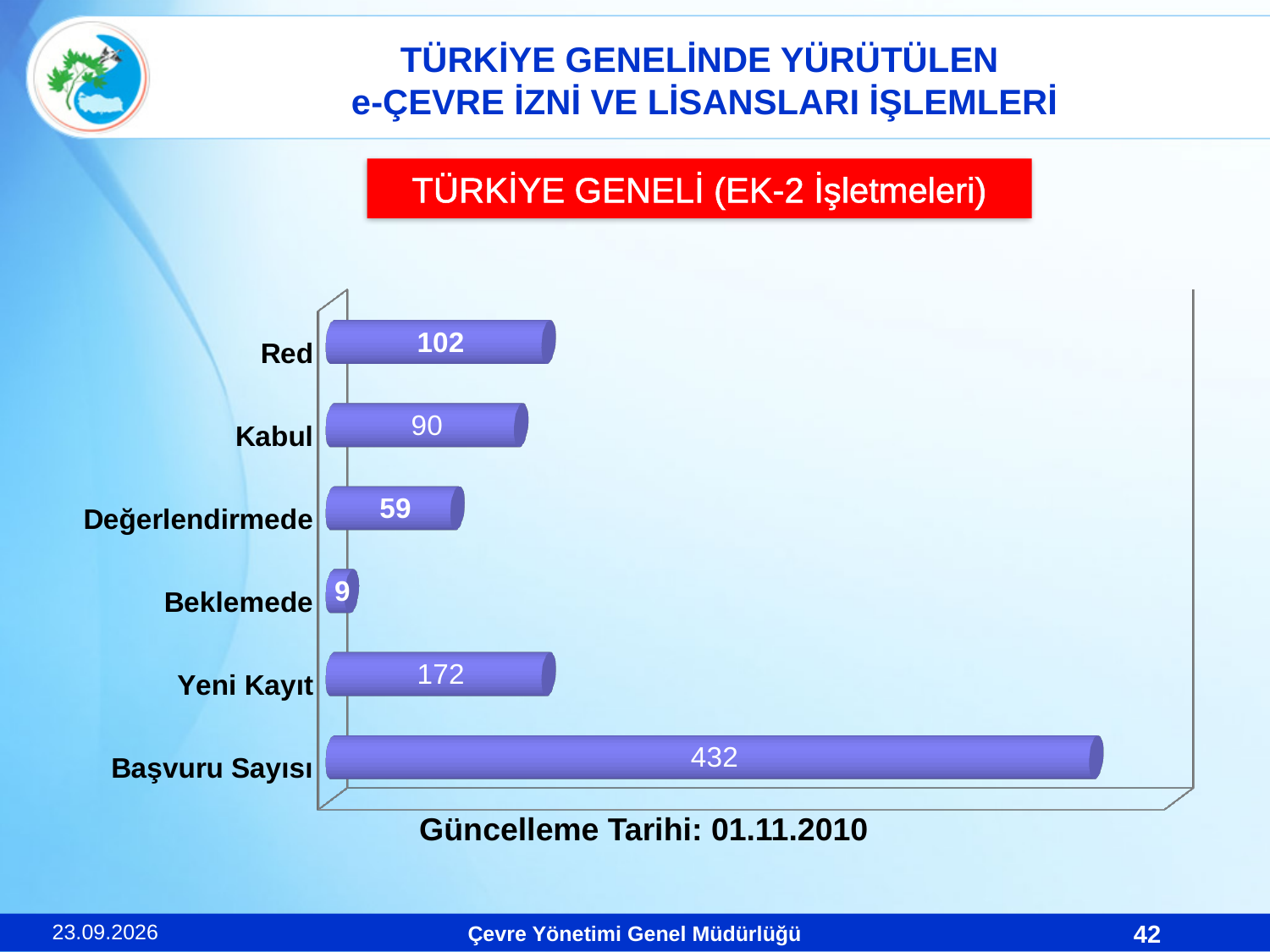
What kind of chart is shown on the slide? Bar chart Which category has the highest value? Başvuru Sayısı What is the value for Beklemede? 9 Which category has the lowest value? Beklemede How many categories are shown in the chart? 6 Which is larger, the value for Yeni Kayıt or the value for Red? Yeni Kayıt What is the value for Başvuru Sayısı? 432 What is the difference between the values for Red and Kabul? 12 What is the value for Yeni Kayıt? 172 What is the value for Kabul? 90 What is the value for Değerlendirmede? 59 What is the value for Red? 102